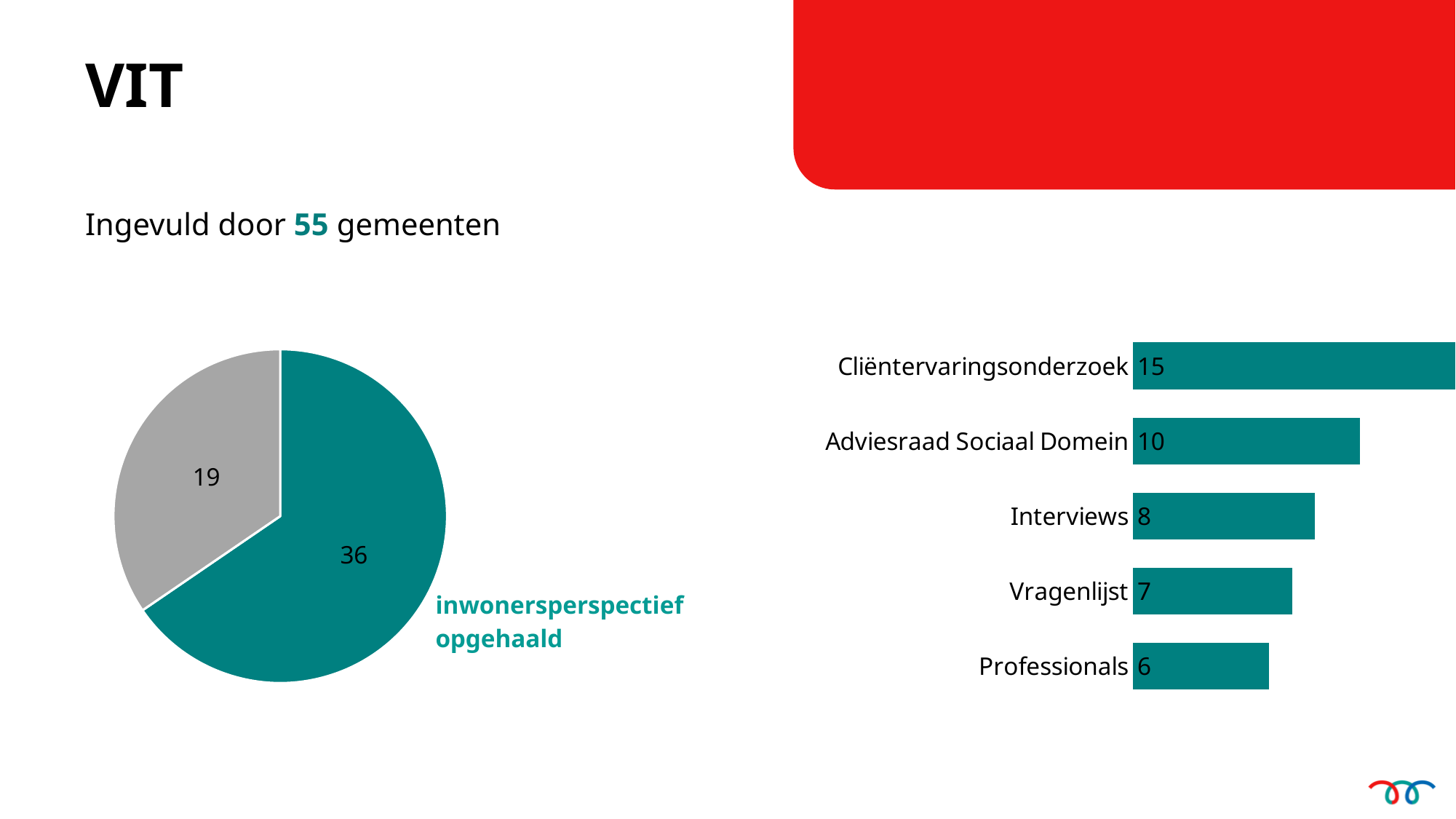
In the pie chart on the left, what is the value of the grey slice? 19 How many categories does the bar chart on the right show? 5 What kind of chart is shown on the left of the slide? Pie chart In the bar chart on the right, what is the value for Vragenlijst? 7 In the pie chart on the left, what is the difference between the two slices? 17 In the bar chart on the right, which category has the highest value? Cliëntervaringsonderzoek In the bar chart on the right, which category has the lowest value? Professionals In the pie chart on the left, what is the value of the teal slice labelled 'inwonersperspectief opgehaald'? 36 In the bar chart on the right, what is the value for Cliëntervaringsonderzoek? 15 What kind of chart is shown on the right of the slide? Bar chart In the bar chart on the right, what is the difference between the values for Cliëntervaringsonderzoek and Professionals? 9 In the bar chart on the right, which is larger: Adviesraad Sociaal Domein or Interviews? Adviesraad Sociaal Domein